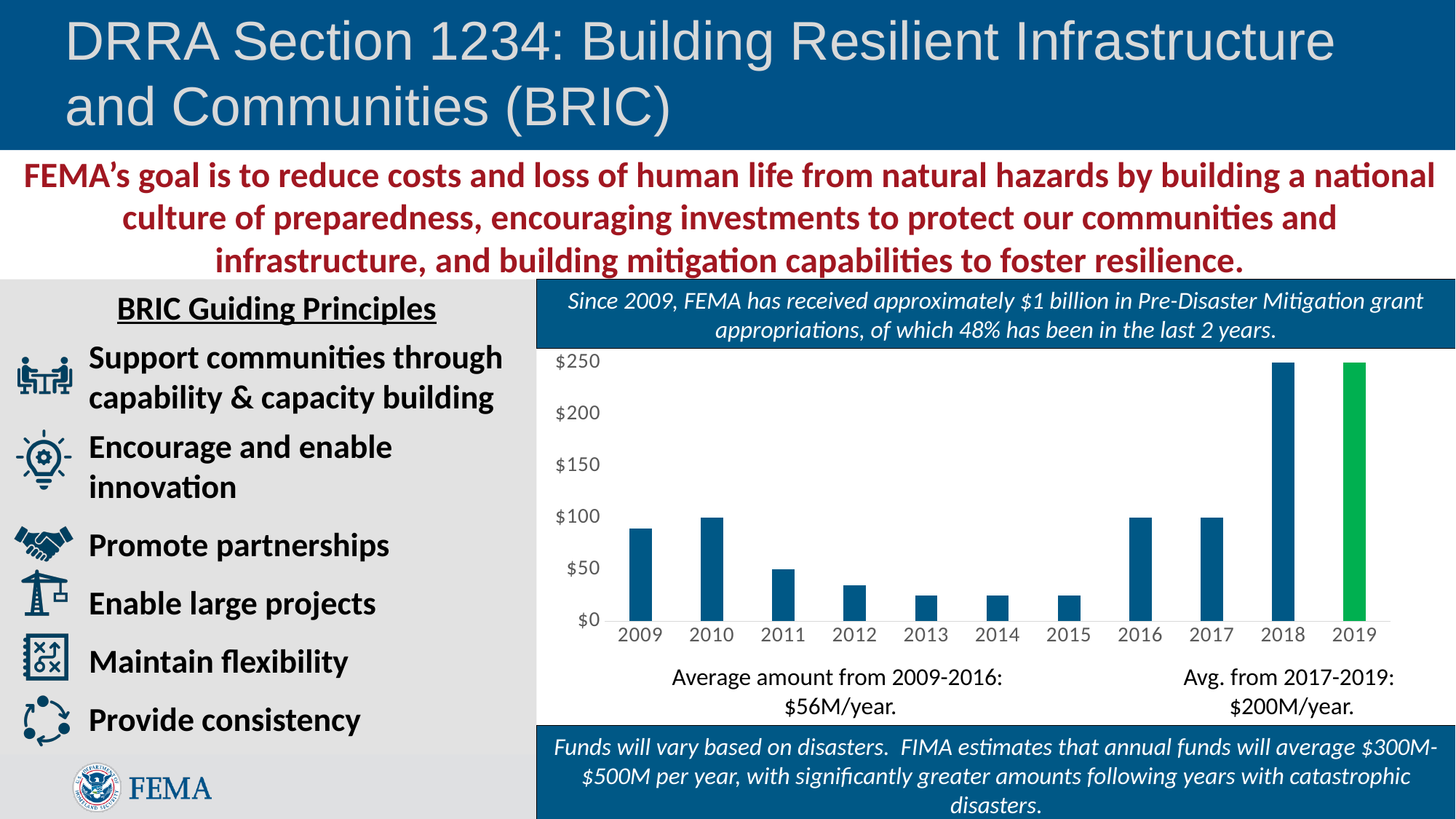
Is the value for 2012 greater or less than $50? less What is the highest value labelled on the y axis of the chart? $250 Is the value for 2014 greater or less than $50? less What kind of chart is shown on the slide? bar chart Which year's bar is coloured green instead of blue? 2019 Which year has the larger value, 2018 or 2012? 2018 Is the value for 2018 greater or less than $200? greater Do the values rise or fall from 2015 to 2018? rise How many years are shown on the x axis of the chart? 11 Which year has the larger value, 2010 or 2013? 2010